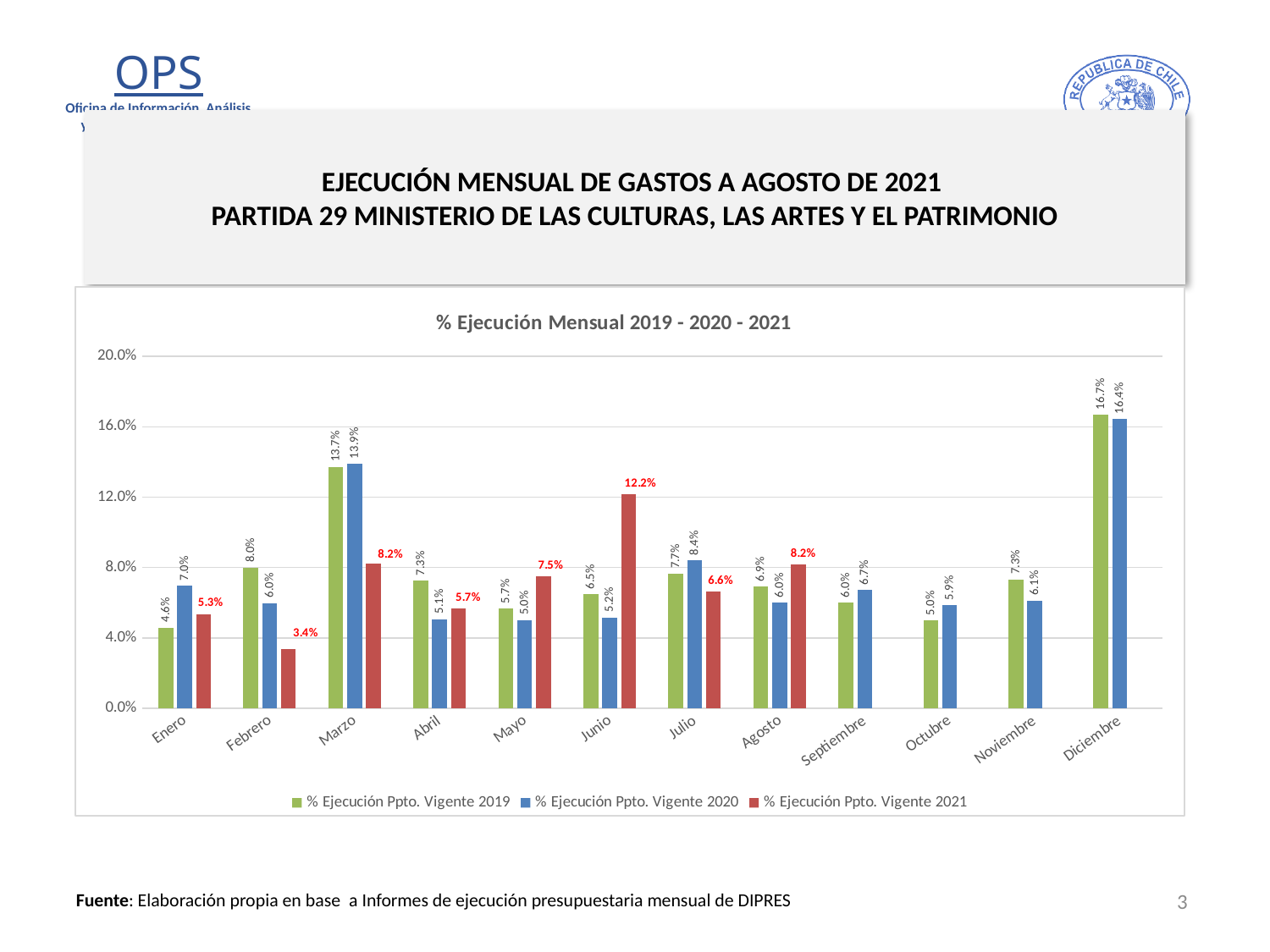
Is the value for Marzo in the 2019 series greater or less than 12.0%? greater What is the value for Diciembre in the % Ejecución Ppto. Vigente 2019 series? 16.7% Which month has the lowest value in the % Ejecución Ppto. Vigente 2019 series? Enero How many months are shown on the x axis? 12 Which month has the highest value in the % Ejecución Ppto. Vigente 2021 series? Junio Which is larger for Agosto: the 2019 value or the 2021 value? 2021 value (8.2%) What is the title of the chart? % Ejecución Mensual 2019 - 2020 - 2021 What is the value for Febrero in the % Ejecución Ppto. Vigente 2021 series? 3.4% What is the difference between the 2020 and 2019 values for Marzo? 0.2% What is the value for Junio in the % Ejecución Ppto. Vigente 2021 series? 12.2% How many series does the legend list? 3 What kind of chart is shown on the slide? Bar chart